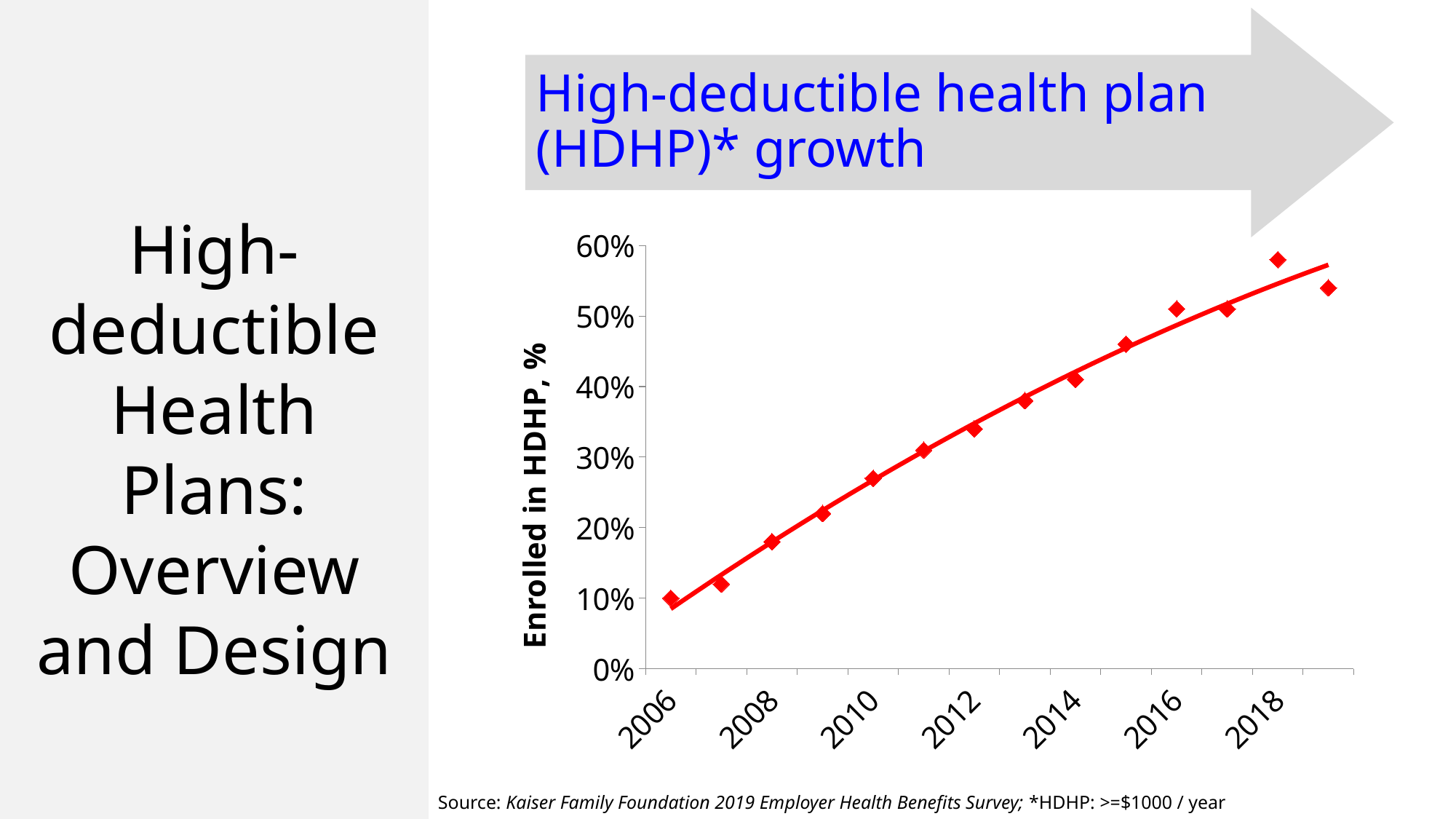
Is the value for 2018 greater or less than 50%? greater How many data points are plotted on the chart? 14 Which year has the lowest percentage enrolled in HDHP? 2006 Which year has the highest percentage enrolled in HDHP? 2018 What kind of chart is shown on the slide? scatter chart with a trend line Do the values generally rise or fall from 2006 to 2019? rise Which year has the larger value, 2018 or 2019? 2018 Is the value for 2012 greater or less than 30%? greater Is the value for 2008 greater or less than 20%? less What is the label on the vertical axis of the chart? Enrolled in HDHP, %